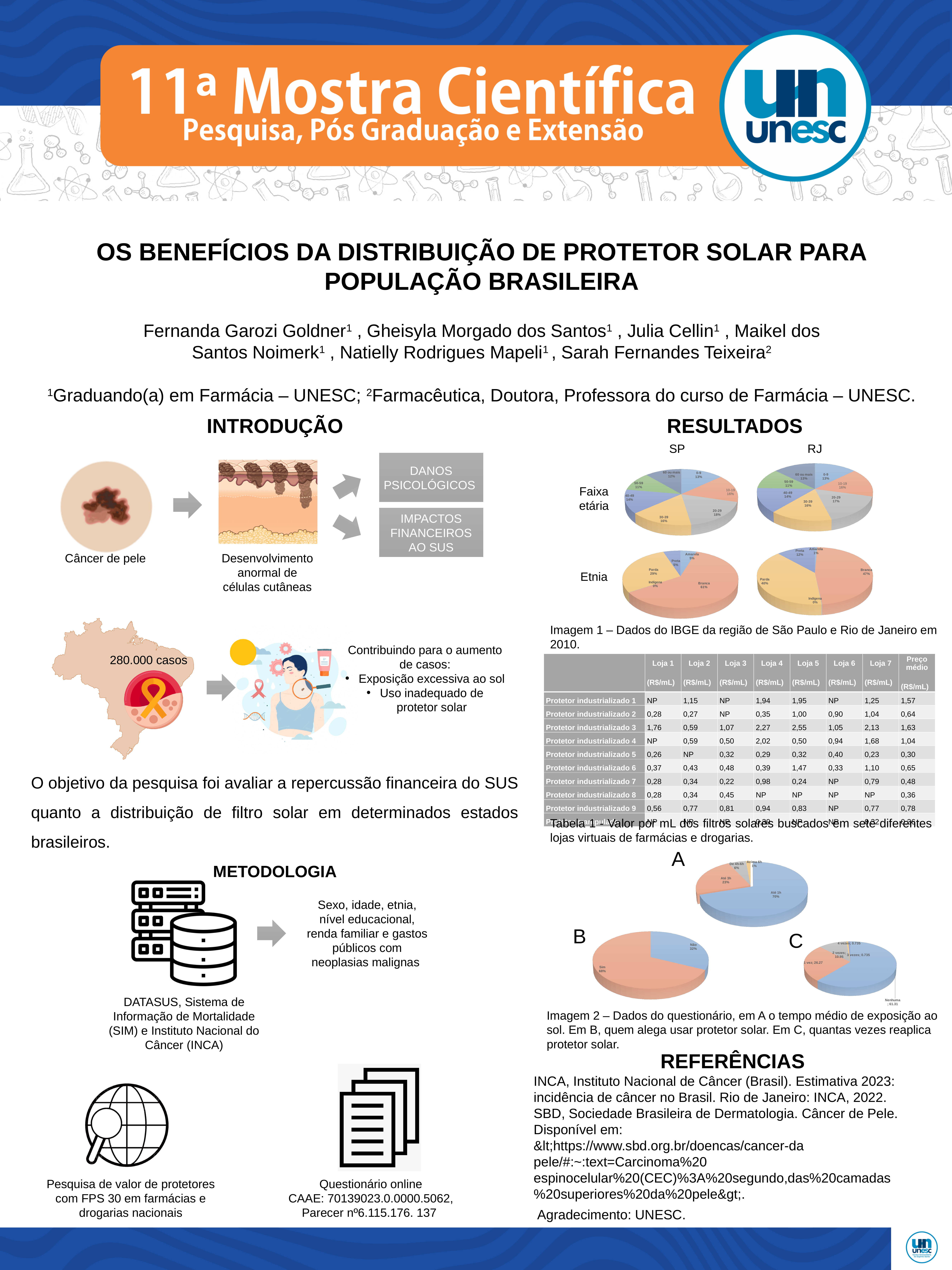
In pie chart B of Imagem 2, which is larger, Sim or Não? Sim What type of chart is chart B in Imagem 2? Pie chart In pie chart A of Imagem 2, what share is labelled Até 1h? 70% In the Etnia pie chart for RJ (Imagem 1), what share is labelled Parda? 40% In the Etnia pie chart for SP (Imagem 1), what is the difference between the Branca and Parda shares? 32% In the Faixa etária pie chart for SP (Imagem 1), what share is labelled 20-29? 18% In the Etnia pie chart for SP (Imagem 1), which category has the smallest share? Indígena In the Etnia pie chart for SP (Imagem 1), what share is labelled Branca? 61% In the Etnia pie chart for RJ (Imagem 1), which category has the largest share? Branca In pie chart B of Imagem 2, what share is labelled Sim? 68% In the Faixa etária pie chart for RJ (Imagem 1), what share is labelled 60 ou mais? 13% In pie chart A of Imagem 2, which category has the largest share? Até 1h